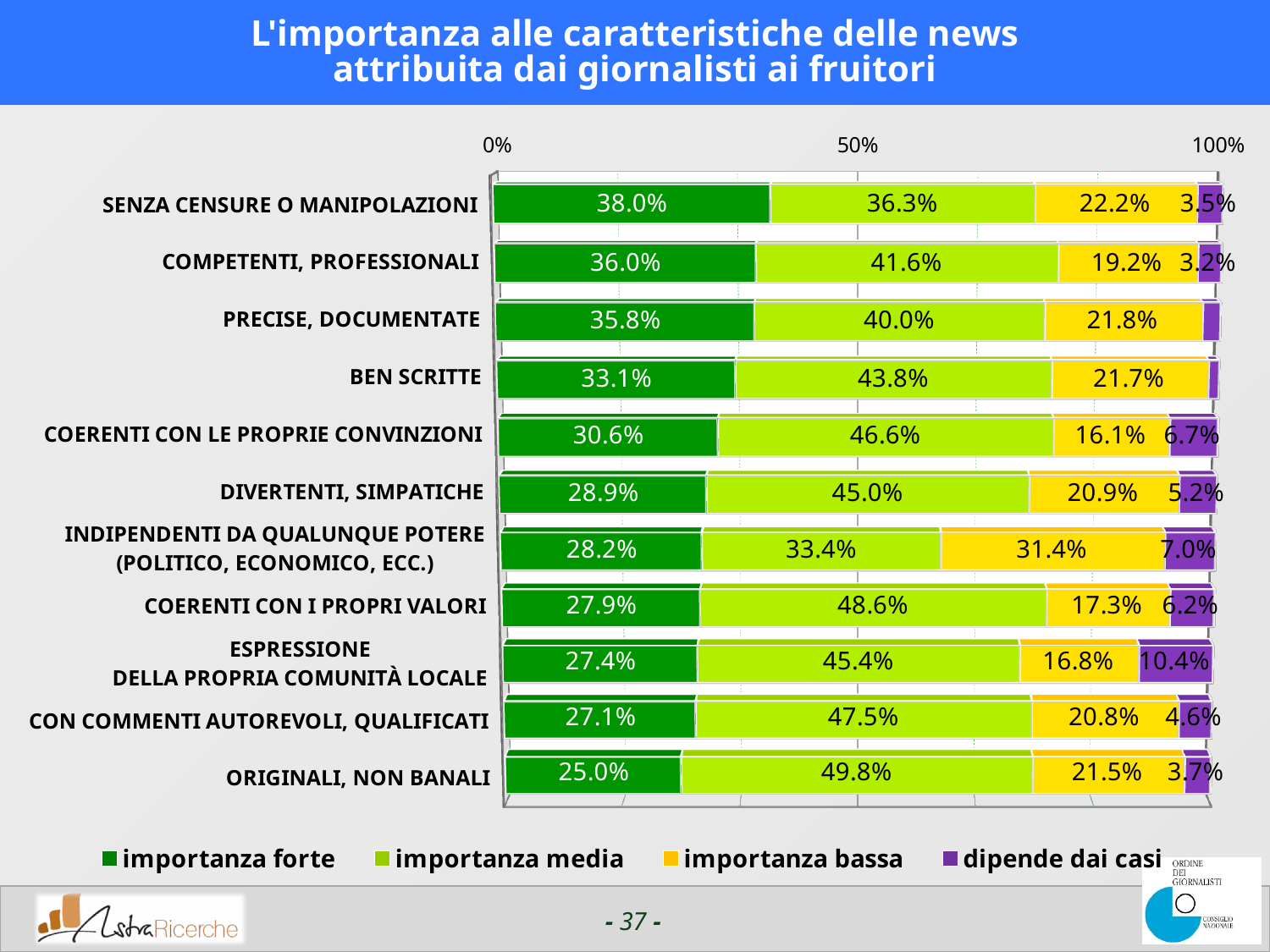
Which category has the lowest 'importanza forte' value? ORIGINALI, NON BANALI Which category has the highest 'importanza forte' value? SENZA CENSURE O MANIPOLAZIONI What is the 'importanza media' value for ORIGINALI, NON BANALI? 49.8% What is the 'importanza forte' value for SENZA CENSURE O MANIPOLAZIONI? 38.0% How many series does the legend list? 4 What kind of chart is shown on the slide? stacked bar chart What is the 'dipende dai casi' value for ESPRESSIONE DELLA PROPRIA COMUNITÀ LOCALE? 10.4% How many categories are plotted on the chart? 11 What is the 'importanza bassa' value for INDIPENDENTI DA QUALUNQUE POTERE (POLITICO, ECONOMICO, ECC.)? 31.4% Which is larger: the 'importanza media' value for COERENTI CON I PROPRI VALORI or for COERENTI CON LE PROPRIE CONVINZIONI? COERENTI CON I PROPRI VALORI Which legend entry is shown in purple? dipende dai casi What is the difference between the 'importanza forte' values for COMPETENTI, PROFESSIONALI and BEN SCRITTE? 2.9%